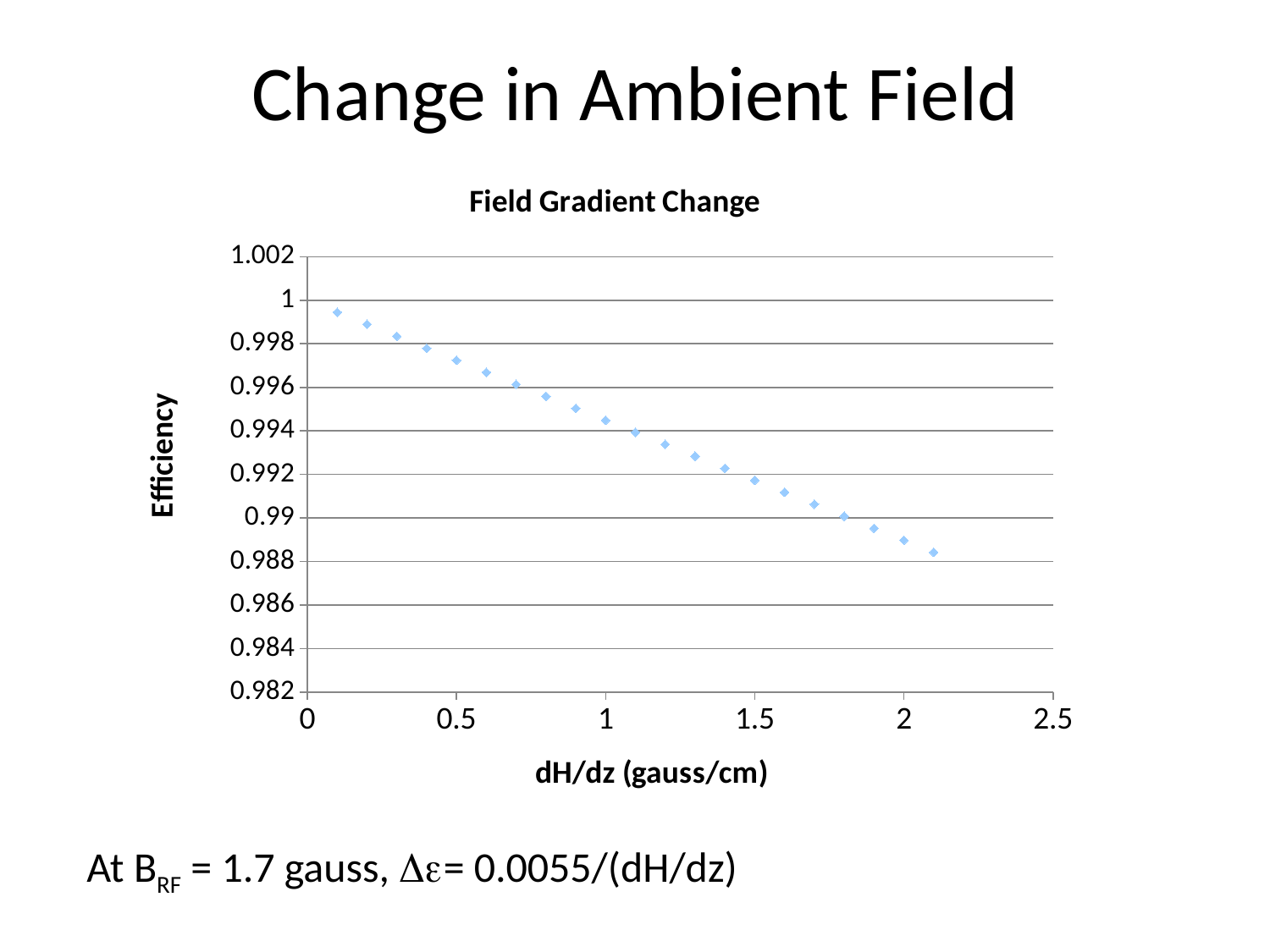
Is the efficiency at dH/dz = 1 greater or less than 0.996? less At which dH/dz value is the efficiency lowest? 2.1 Which has the higher efficiency, dH/dz = 0.5 or dH/dz = 1.5? dH/dz = 0.5 What kind of chart is shown on the slide? scatter chart What is the title of the chart? Field Gradient Change At which dH/dz value is the efficiency highest? 0.1 Is the efficiency at dH/dz = 2.1 greater or less than 0.99? less Is the efficiency at dH/dz = 0.1 greater or less than 0.998? greater How many data points are plotted on the chart? 21 What is the label of the x axis? dH/dz (gauss/cm) Does efficiency rise or fall as dH/dz increases? fall